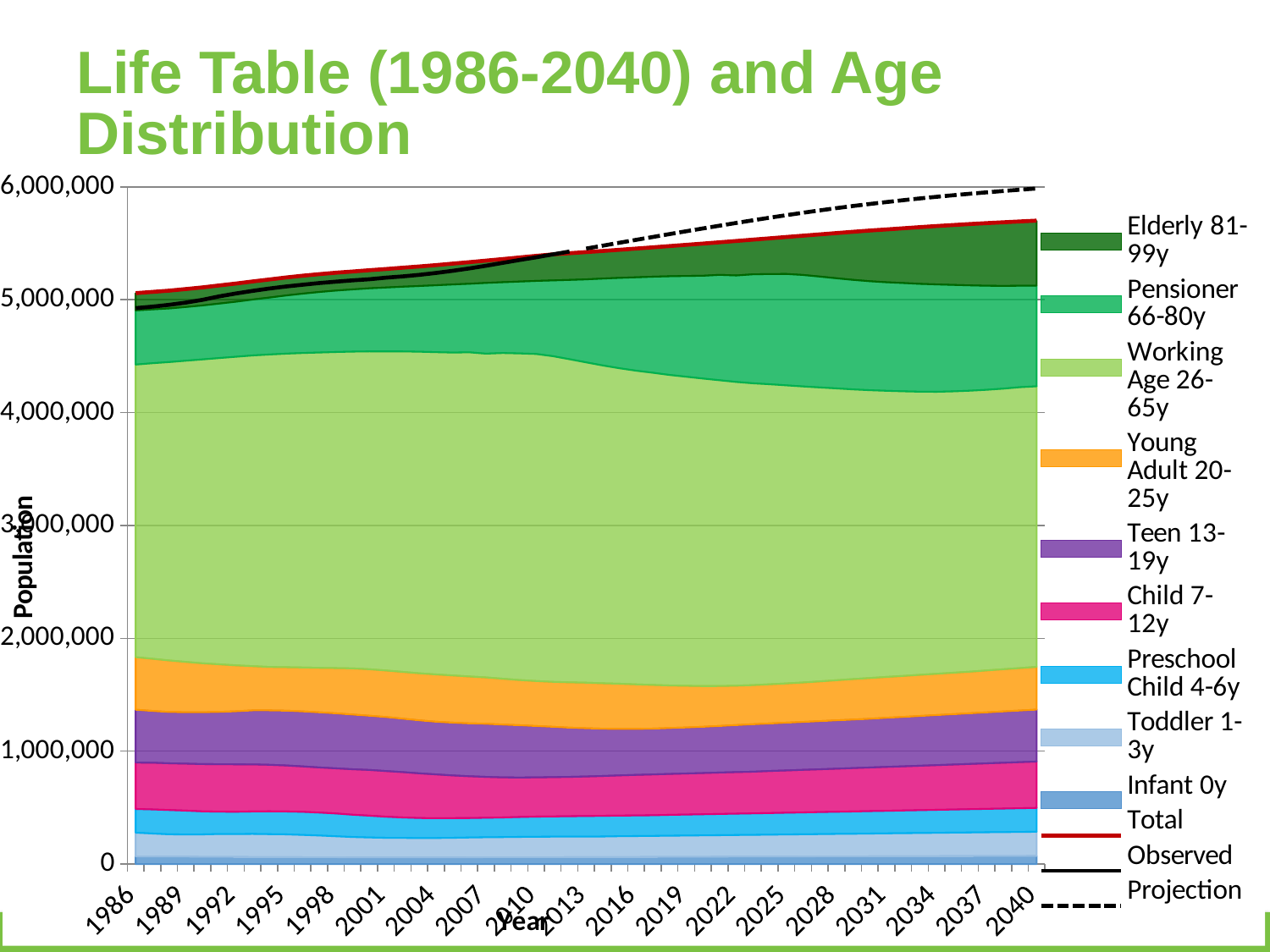
Does the Elderly 81-99y band get larger or smaller from 1986 to 2040? larger Is the Projection value in 2025 greater or less than 5,000,000? greater Is the Total population in 2040 greater or less than 5,000,000? greater Is the Elderly 81-99y band larger in 2040 or in 1986? 2040 Which age group occupies the largest share of the stacked area? Working Age 26-65y What kind of chart is shown on the slide? Stacked area chart How many year labels are shown along the x axis? 19 How many entries does the chart legend list? 12 What is the label on the y axis of the chart? Population What is the title of the slide? Life Table (1986-2040) and Age Distribution Does the Projection line rise or fall from 2013 to 2040? rises Is the Total population in 2040 greater or less than 6,000,000? less